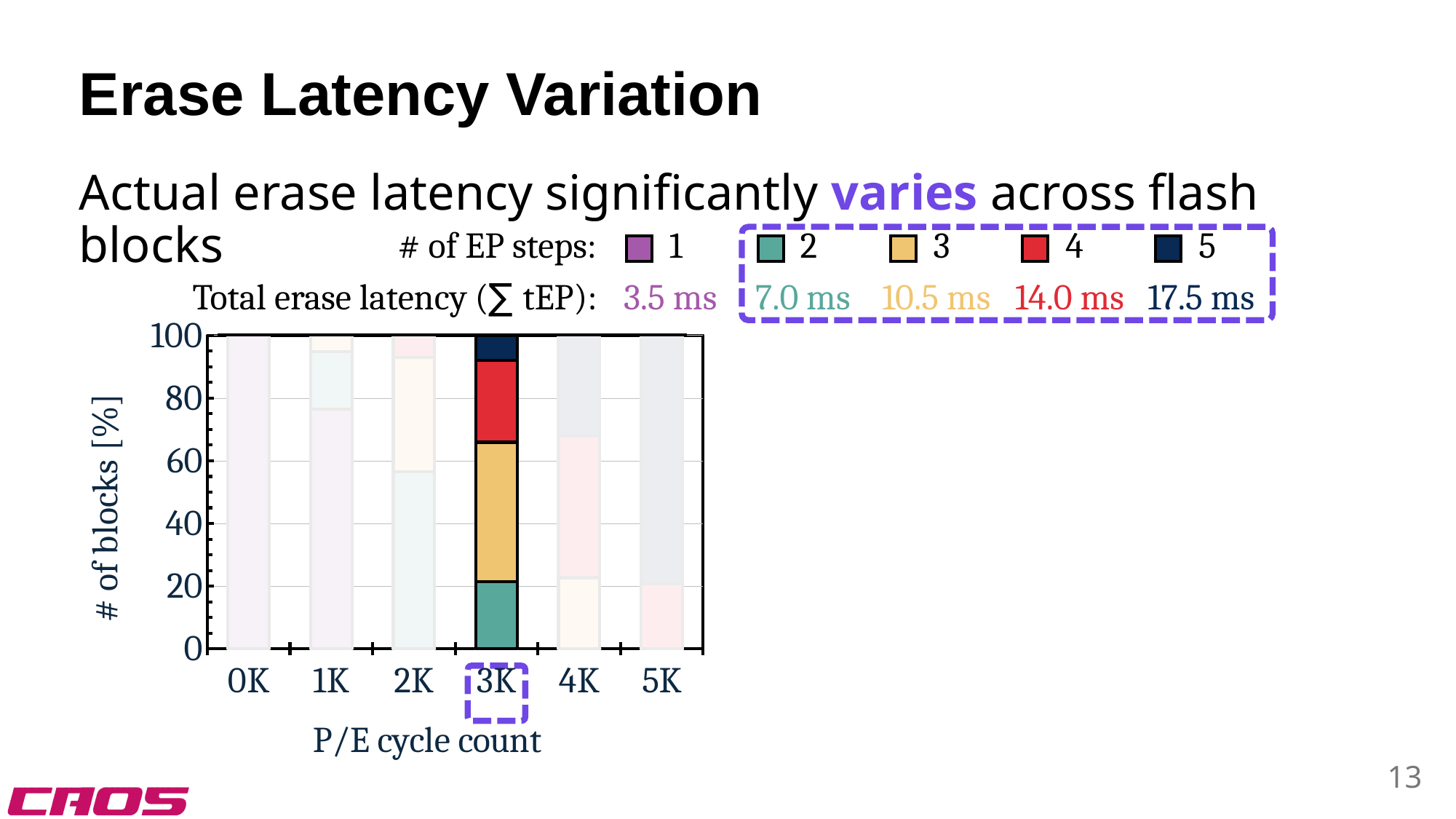
At 3K P/E cycles, is the share of blocks with 3 EP steps greater or less than 40%? greater What kind of chart is shown on the slide? stacked bar chart How many series (# of EP steps) does the legend list? 5 At 3K P/E cycles, which number of EP steps accounts for the largest share of blocks? 3 According to the legend, what is the total erase latency for 5 EP steps? 17.5 ms At 3K P/E cycles, which number of EP steps accounts for the smallest share of blocks? 5 Which P/E cycle count category is highlighted with a dashed box on the x axis? 3K At 3K P/E cycles, is the share of blocks with 2 EP steps greater or less than 40%? less According to the legend, what is the total erase latency for 3 EP steps? 10.5 ms What is the total height of the stacked bar at 3K P/E cycles? 100 How many P/E cycle count categories are shown on the x axis? 6 What is the label of the x axis? P/E cycle count